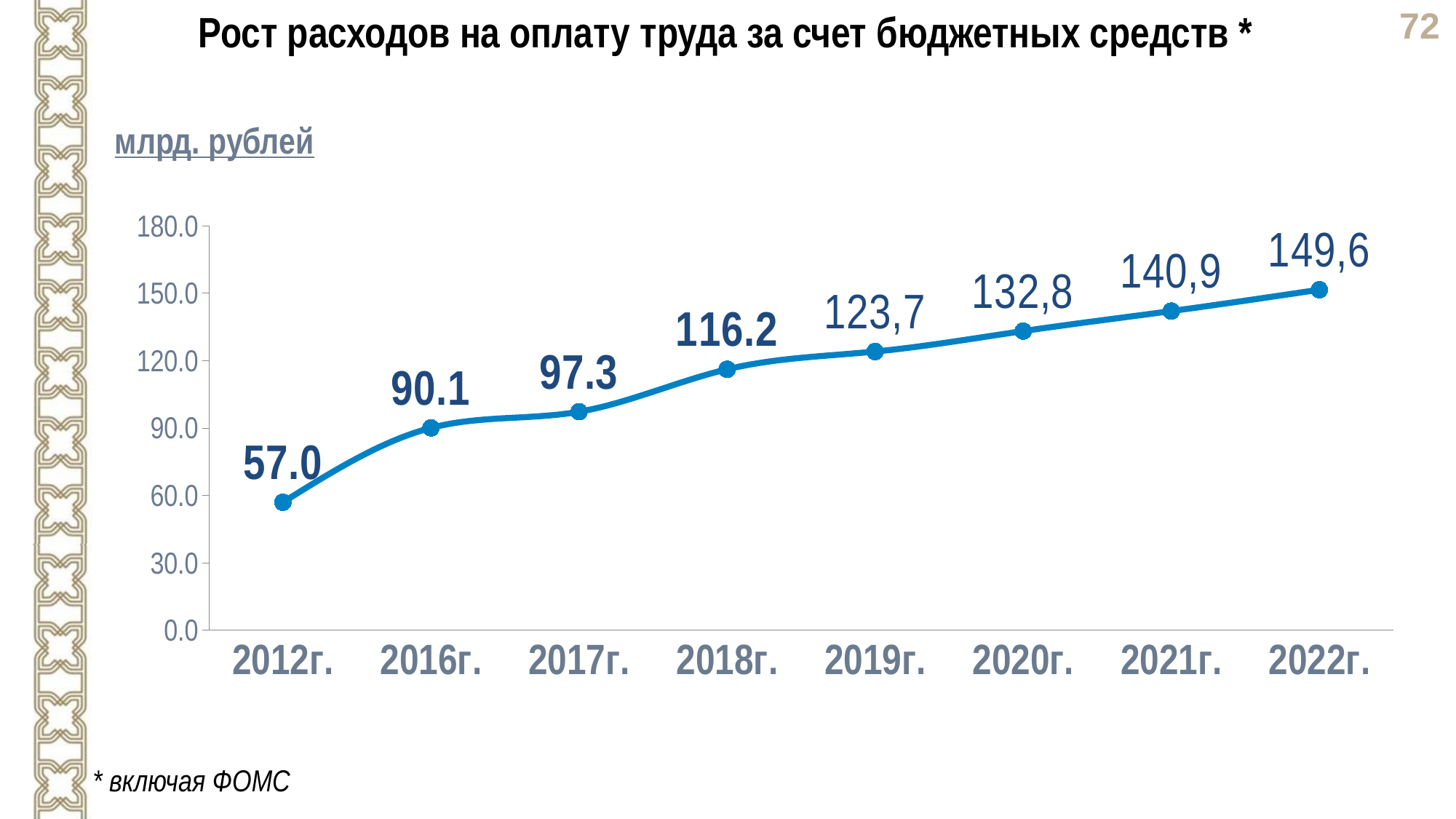
What is the value for 2022г.? 149,6 How many data points are plotted on the chart? 8 What is the difference between the values for 2022г. and 2021г.? 8,7 Which is larger, the value for 2016г. or the value for 2019г.? 2019г. What kind of chart is shown on the slide? line chart What is the value for 2018г.? 116.2 What is the value for 2020г.? 132,8 What is the value for 2012г.? 57.0 Do the values rise or fall from 2012г. to 2022г.? rise Which year has the lowest value? 2012г. Which year has the highest value? 2022г. What is the difference between the values for 2018г. and 2017г.? 18.9